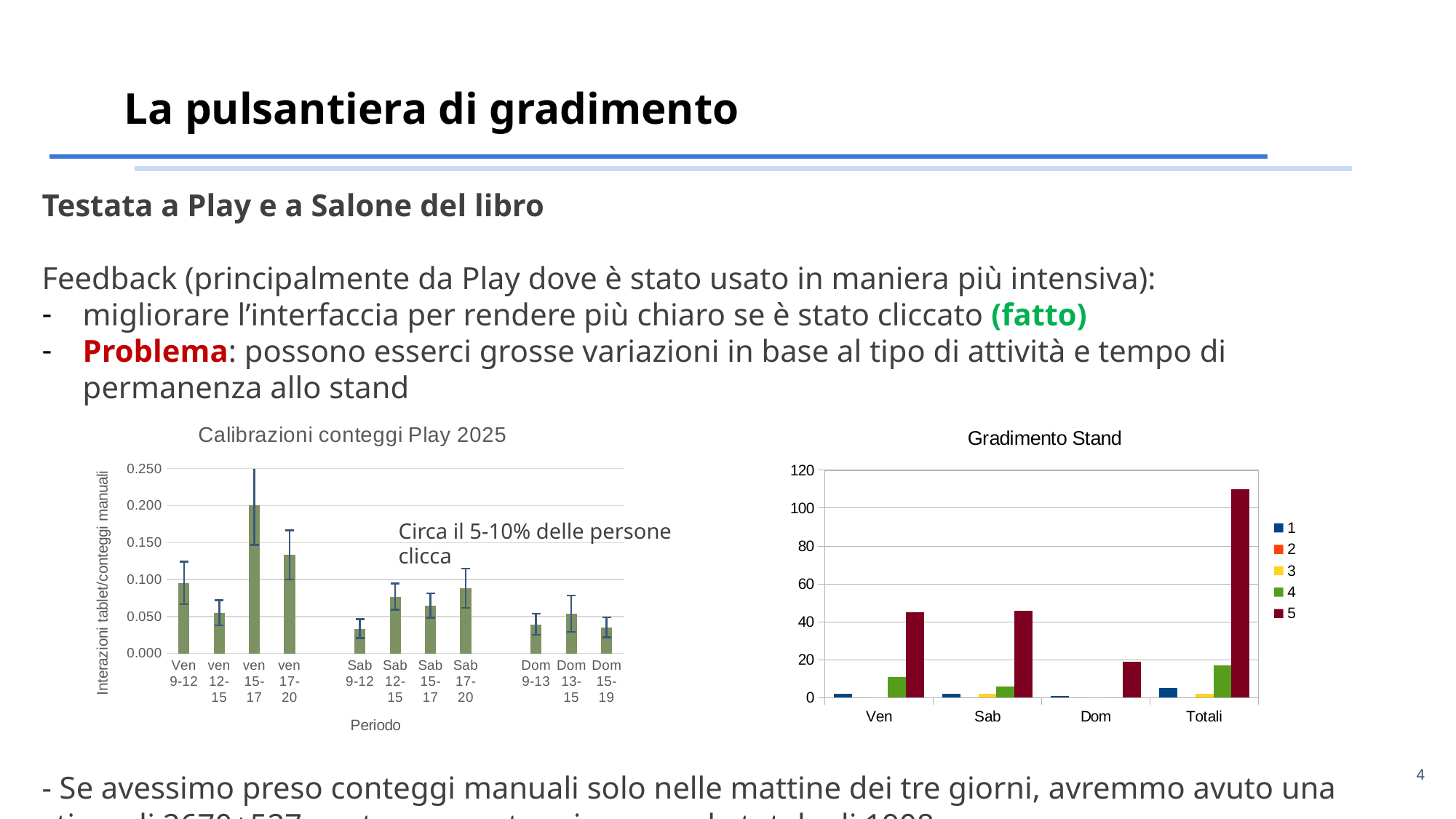
In the 'Calibrazioni conteggi Play 2025' chart, which period has the highest value? ven 15-17 In the 'Calibrazioni conteggi Play 2025' chart, is the value for ven 15-17 greater or less than 0.150? greater In the 'Calibrazioni conteggi Play 2025' chart, is the value for Sab 9-12 greater or less than 0.050? less In the 'Calibrazioni conteggi Play 2025' chart, which is larger: the value for ven 15-17 or for Sab 12-15? ven 15-17 In the 'Gradimento Stand' chart, which is larger: the value of series 4 for Ven or for Sab? Ven How many categories are shown on the x axis of the 'Gradimento Stand' chart? 4 How many periods are shown on the x axis of the 'Calibrazioni conteggi Play 2025' chart? 11 What is the y-axis label of the 'Calibrazioni conteggi Play 2025' chart? Interazioni tablet/conteggi manuali In the 'Gradimento Stand' chart, is the value of series 5 for Totali greater or less than 100? greater What type of chart is the 'Calibrazioni conteggi Play 2025' chart? bar chart How many series does the legend of the 'Gradimento Stand' chart list? 5